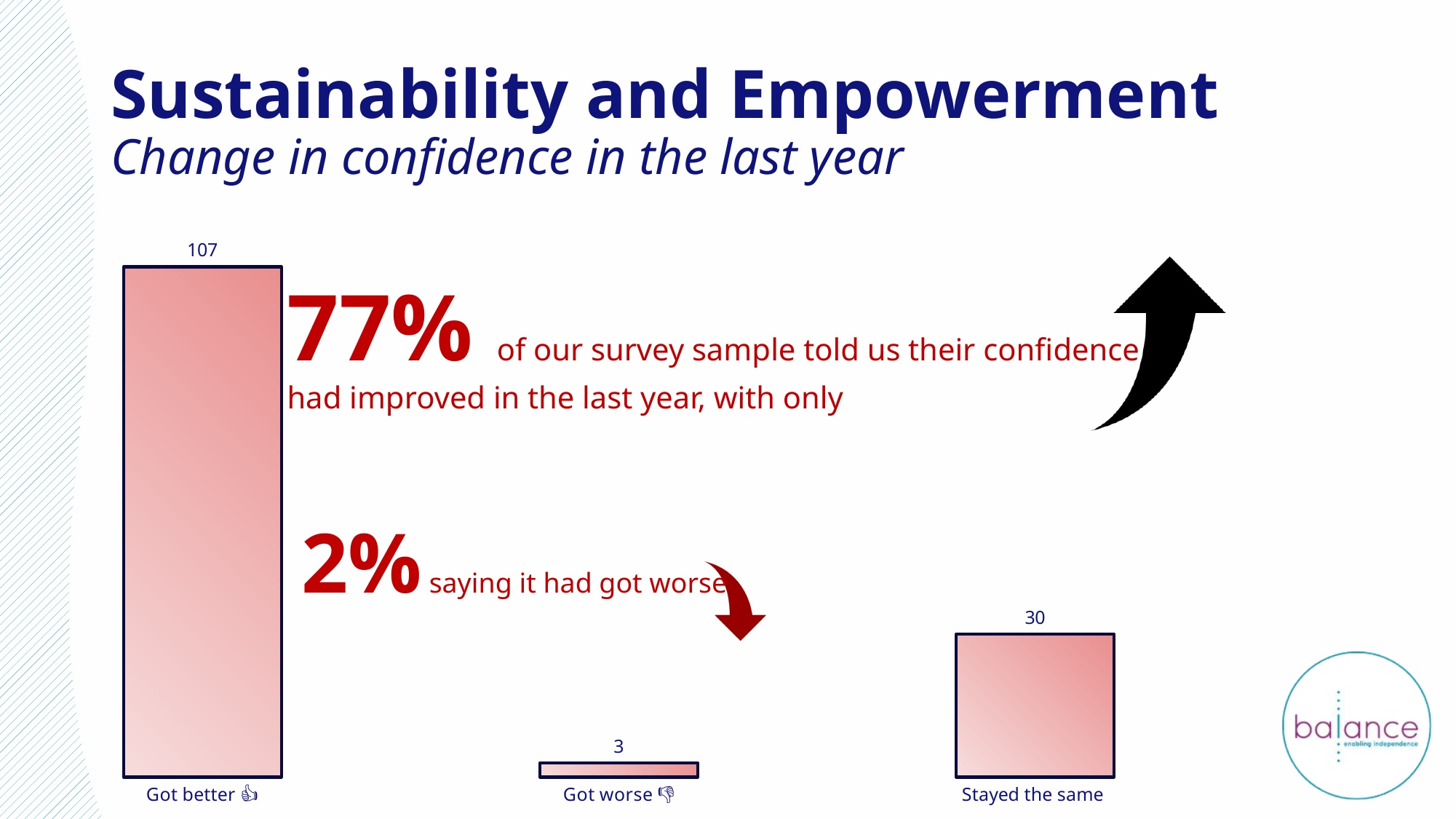
Which category has the highest value? Got better What is the value for Stayed the same? 30 What kind of chart is shown on the slide? Bar chart Which category has the lowest value? Got worse How many categories are shown in the chart? 3 What is the subtitle of the chart on the slide? Change in confidence in the last year What is the total of the three bar values in the chart? 140 Which is larger, the value for Stayed the same or the value for Got worse? Stayed the same What is the difference between the values for Got better and Stayed the same? 77 What is the value for Got better? 107 What is the value for Got worse? 3 What is the difference between the values for Stayed the same and Got worse? 27